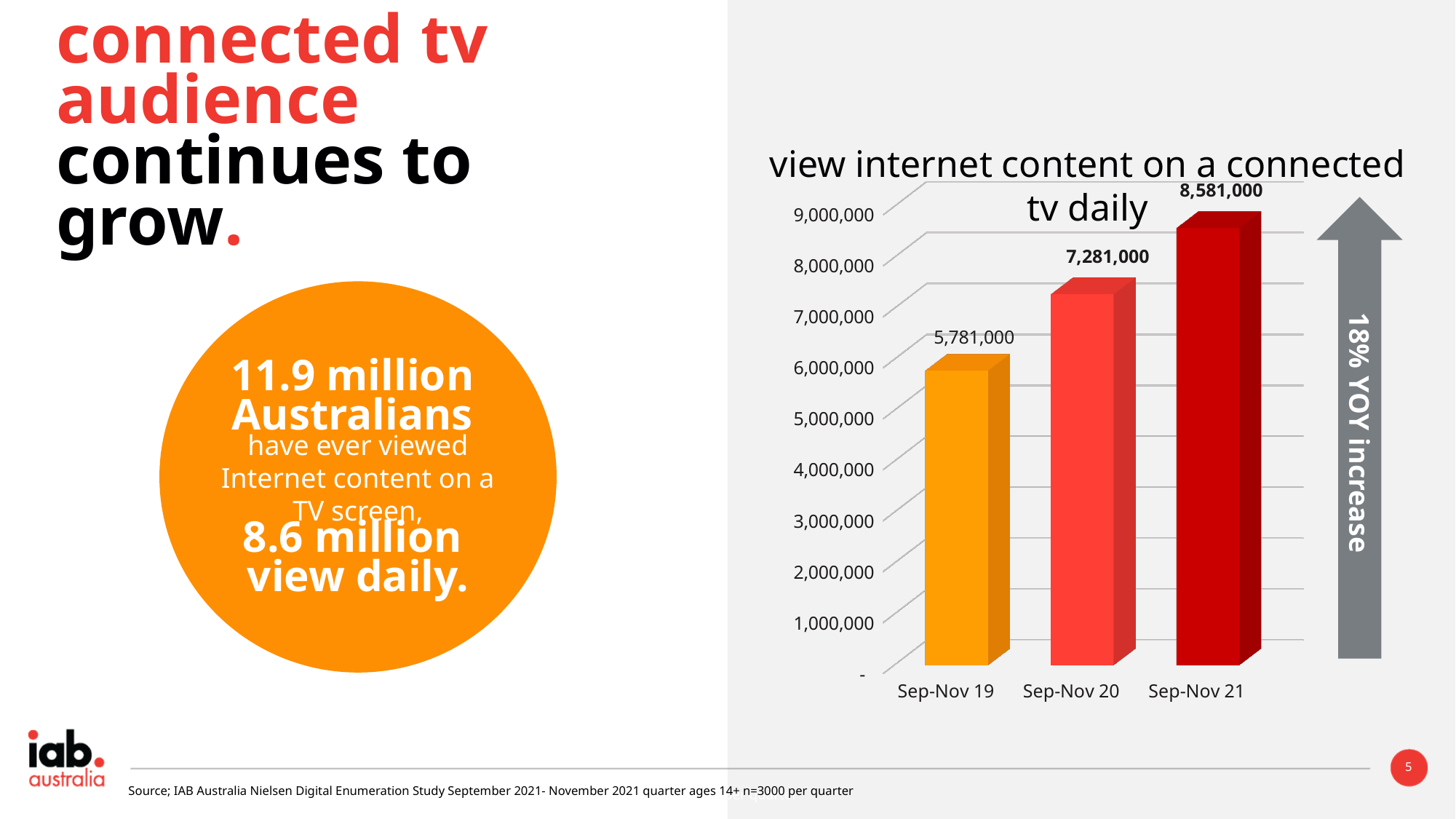
How many periods are shown on the x axis? 3 Is the value for Sep-Nov 21 greater or less than 8,000,000? greater What is the value for Sep-Nov 19? 5,781,000 What is the difference between the values for Sep-Nov 21 and Sep-Nov 20? 1,300,000 Which period has the lowest value? Sep-Nov 19 Do the values rise or fall from Sep-Nov 19 to Sep-Nov 21? rise What is the value for Sep-Nov 21? 8,581,000 Which period has the highest value? Sep-Nov 21 What is the value for Sep-Nov 20? 7,281,000 What is the difference between the values for Sep-Nov 20 and Sep-Nov 19? 1,500,000 What kind of chart is shown on the slide? bar chart Which is larger, the value for Sep-Nov 19 or Sep-Nov 20? Sep-Nov 20